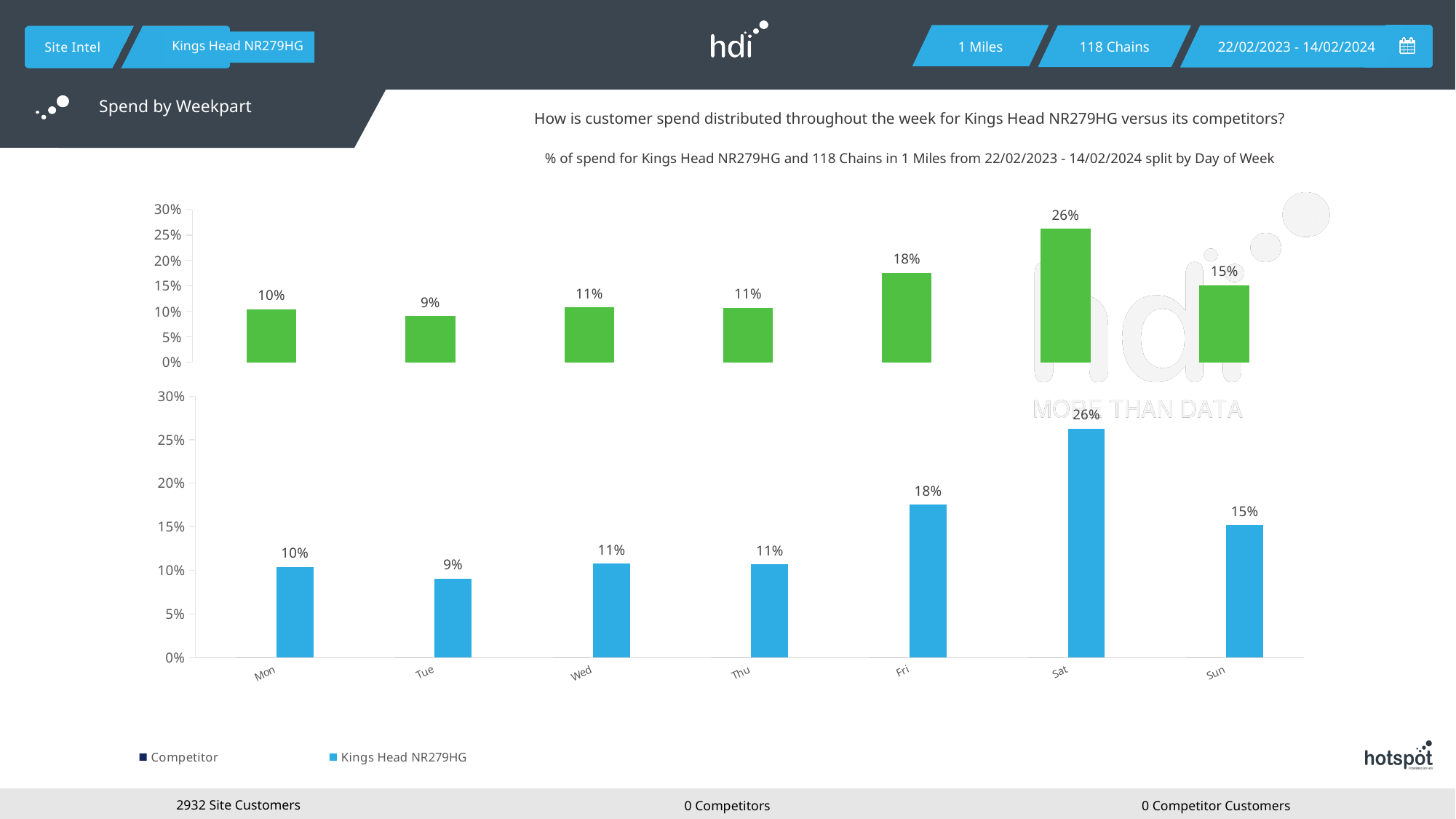
How many series does the legend list? 2 What type of chart is the bottom chart? bar chart On the bottom chart (blue bars), which is larger, the value for Fri or the value for Sun? Fri On the bottom chart (blue bars), what is the value for Tue? 9% On the bottom chart (blue bars), what is the value for Sat? 26% What is the highest data label shown on the top chart (green bars)? 26% On the bottom chart (blue bars), is the value for Sat greater or less than 20%? greater On the bottom chart (blue bars), what is the value for Fri? 18% On the bottom chart (blue bars), what is the difference between the values for Sat and Sun? 11% On the bottom chart (blue bars), which day has the lowest value? Tue On the bottom chart (blue bars), which day has the highest value? Sat How many days are shown on the x axis of the bottom chart? 7